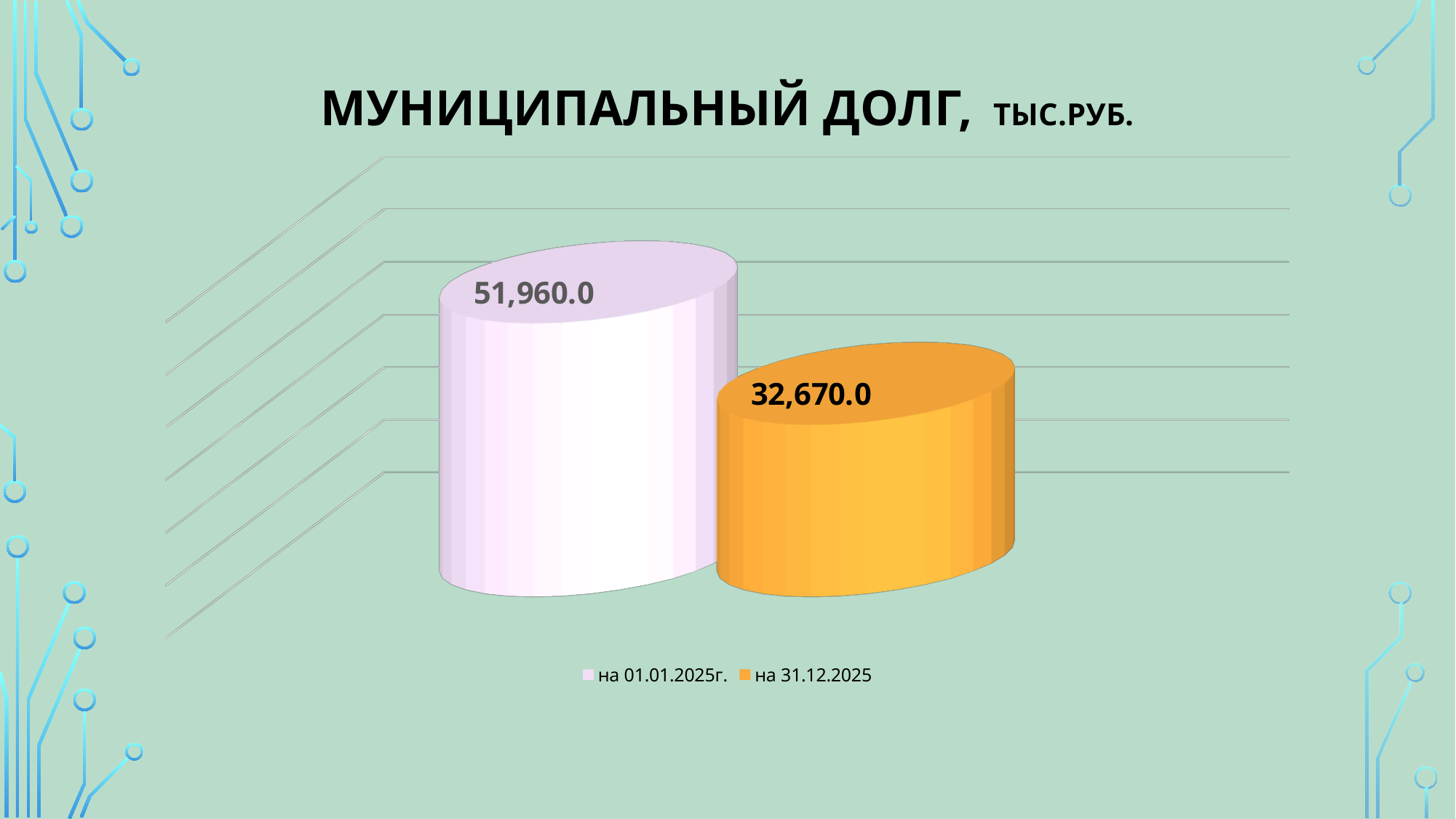
What is the difference between the value for на 01.01.2025г. and the value for на 31.12.2025? 19,290.0 What is the title of the chart? МУНИЦИПАЛЬНЫЙ ДОЛГ, ТЫС.РУБ. What colour is the bar for на 31.12.2025? orange Which series shows the lowest municipal debt value? на 31.12.2025 How many bars are plotted on the chart? 2 Which series has the higher value, на 01.01.2025г. or на 31.12.2025? на 01.01.2025г. Does the municipal debt rise or fall from на 01.01.2025г. to на 31.12.2025? fall What is the municipal debt value for на 31.12.2025? 32,670.0 What kind of chart is shown on the slide? bar chart How many series does the legend list? 2 Which series shows the highest municipal debt value? на 01.01.2025г. What is the municipal debt value for на 01.01.2025г.? 51,960.0